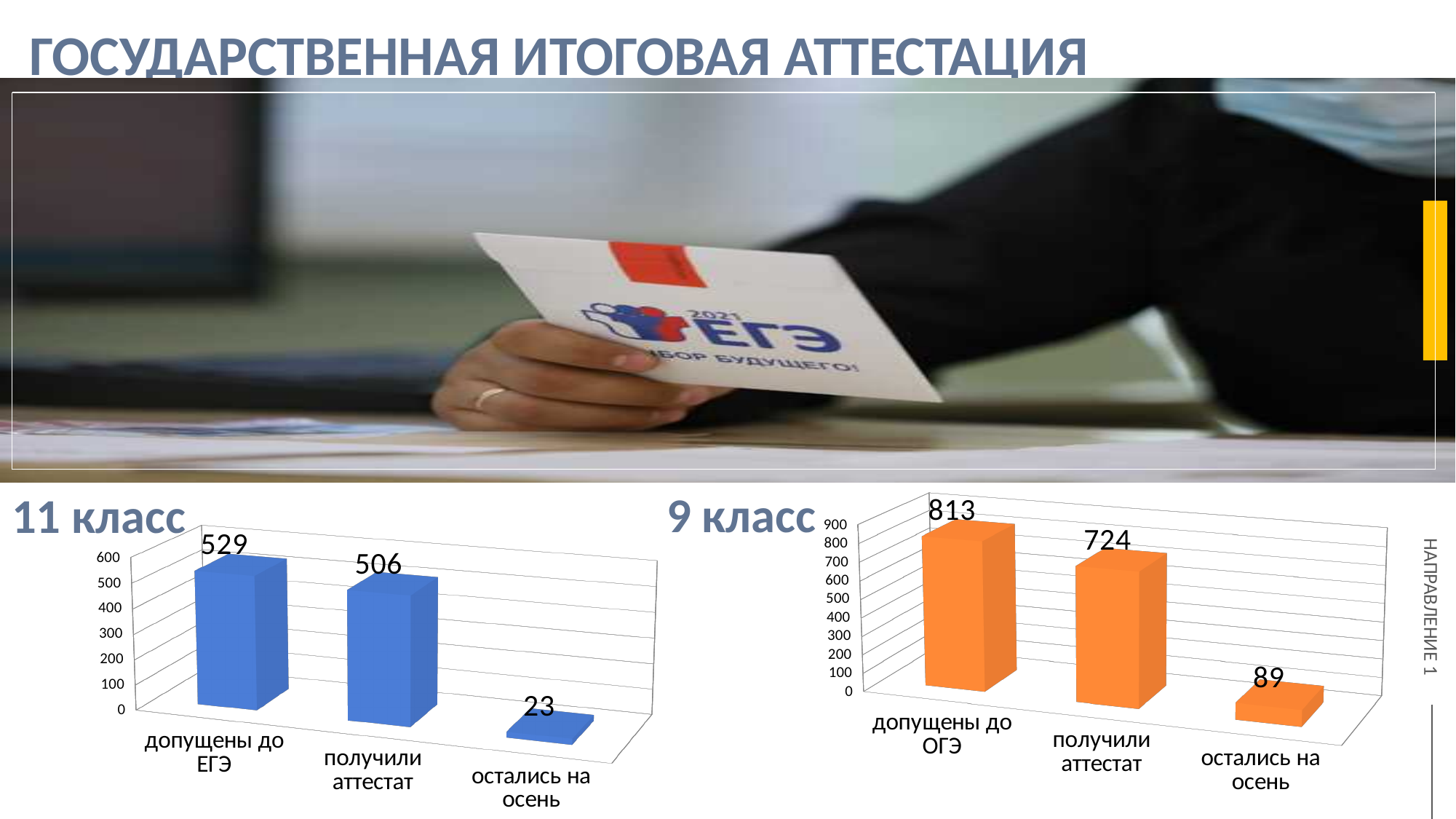
In the "11 класс" chart, which category has the lowest value? остались на осень In the "9 класс" chart, what is the difference between "допущены до ОГЭ" and "получили аттестат"? 89 In the "9 класс" chart, what is the value for "остались на осень"? 89 In the "9 класс" chart, which is larger: "получили аттестат" or "остались на осень"? получили аттестат In the "11 класс" chart, what is the value for "допущены до ЕГЭ"? 529 What type of chart is the "9 класс" chart? bar chart In the "11 класс" chart, what is the value for "остались на осень"? 23 What colour are the bars in the "11 класс" chart? blue In the "11 класс" chart, what is the difference between "допущены до ЕГЭ" and "получили аттестат"? 23 How many categories are shown in the "11 класс" chart? 3 In the "9 класс" chart, what is the value for "получили аттестат"? 724 In the "9 класс" chart, which category has the highest value? допущены до ОГЭ